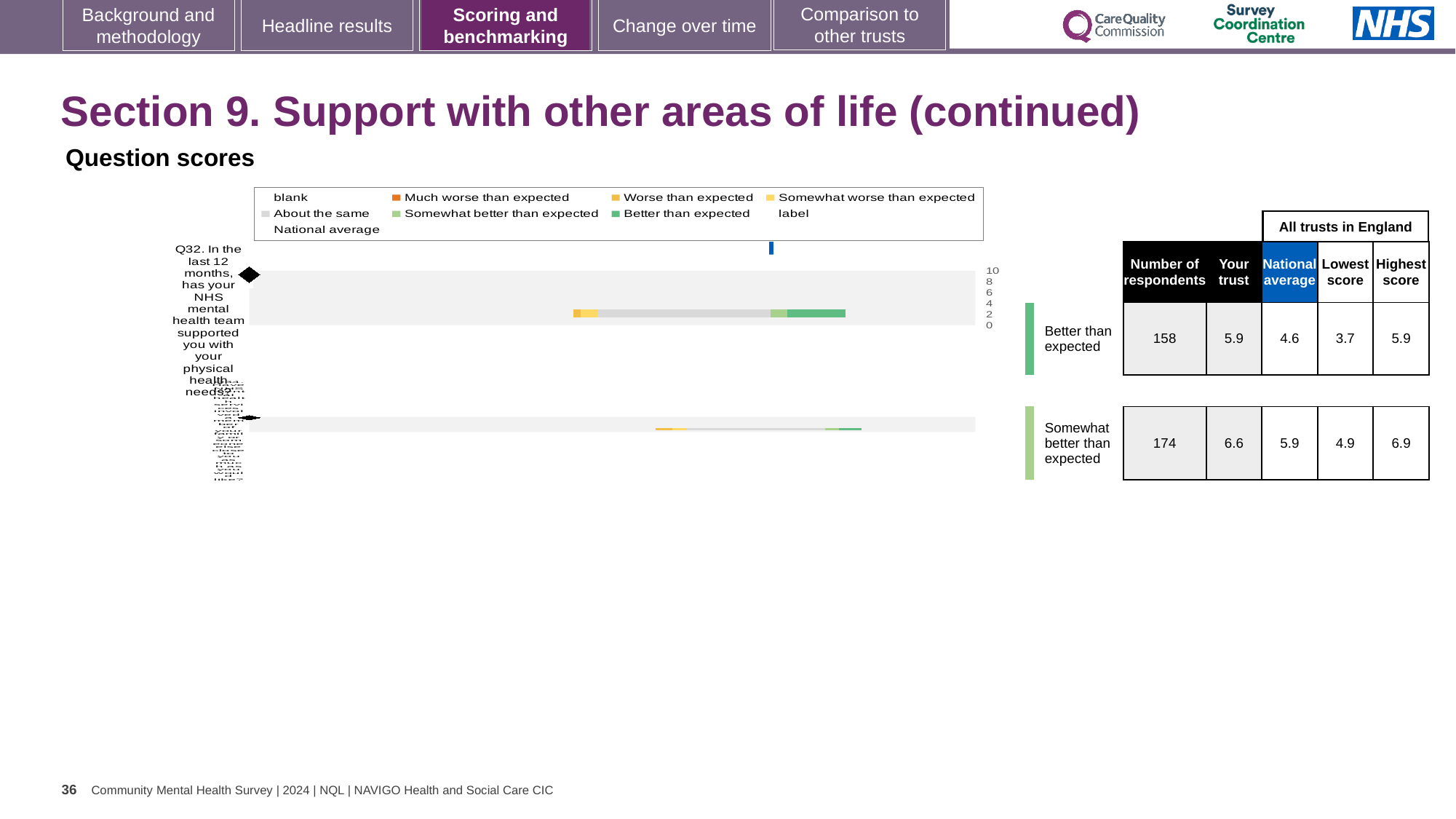
In the table, what is the highest score across all trusts in England for Q32? 5.9 In the table, what is the 'Your trust' score for the second question (rated 'Somewhat better than expected')? 6.6 In the table, what is the lowest score across all trusts in England for Q32? 3.7 What benchmark rating is shown next to Q32? Better than expected In the table, what is the 'Your trust' score for Q32? 5.9 In the table, what is the national average for the second question (rated 'Somewhat better than expected')? 5.9 By how much does the trust's score for Q32 exceed the national average? 1.3 How many questions (bars) are shown in the chart? 2 Which question has more respondents, Q32 or the second question? the second question (174) In the table, what is the number of respondents for Q32 (support with physical health needs)? 158 What kind of chart is shown under 'Question scores'? bar chart In the table, what is the national average for Q32? 4.6